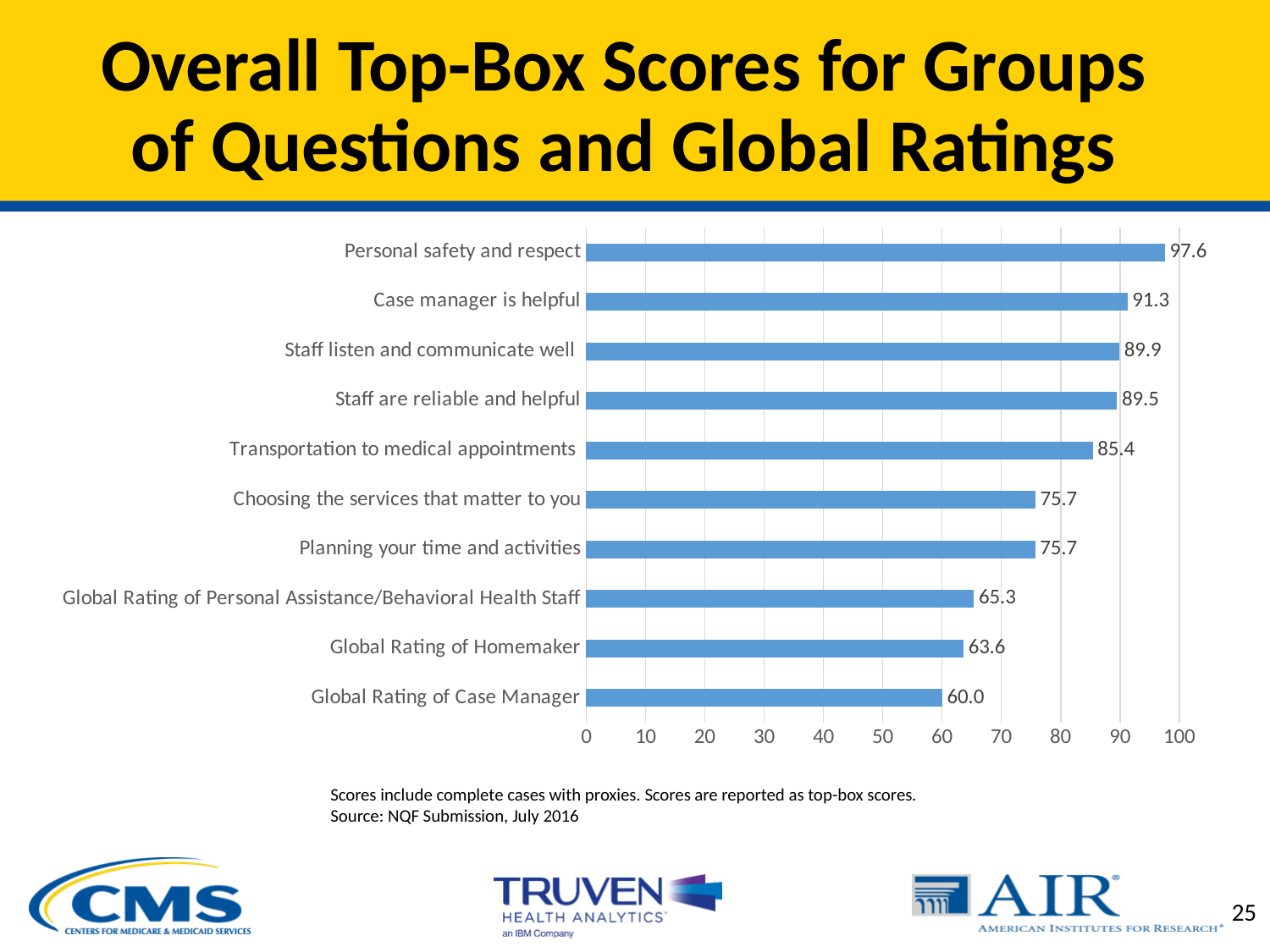
Which has a higher score: Staff listen and communicate well or Staff are reliable and helpful? Staff listen and communicate well What is the top-box score for Global Rating of Homemaker? 63.6 Which category has the highest top-box score? Personal safety and respect Is the value for Global Rating of Personal Assistance/Behavioral Health Staff greater or less than 70? less What is the top-box score for Personal safety and respect? 97.6 Which category has the lowest top-box score? Global Rating of Case Manager What kind of chart is shown on the slide? Bar chart How many categories are shown in the bar chart? 10 What is the difference between the scores for Case manager is helpful and Global Rating of Case Manager? 31.3 What is the top-box score for Transportation to medical appointments? 85.4 What is the difference between the scores for Personal safety and respect and Global Rating of Homemaker? 34.0 What is the maximum value shown on the horizontal axis? 100